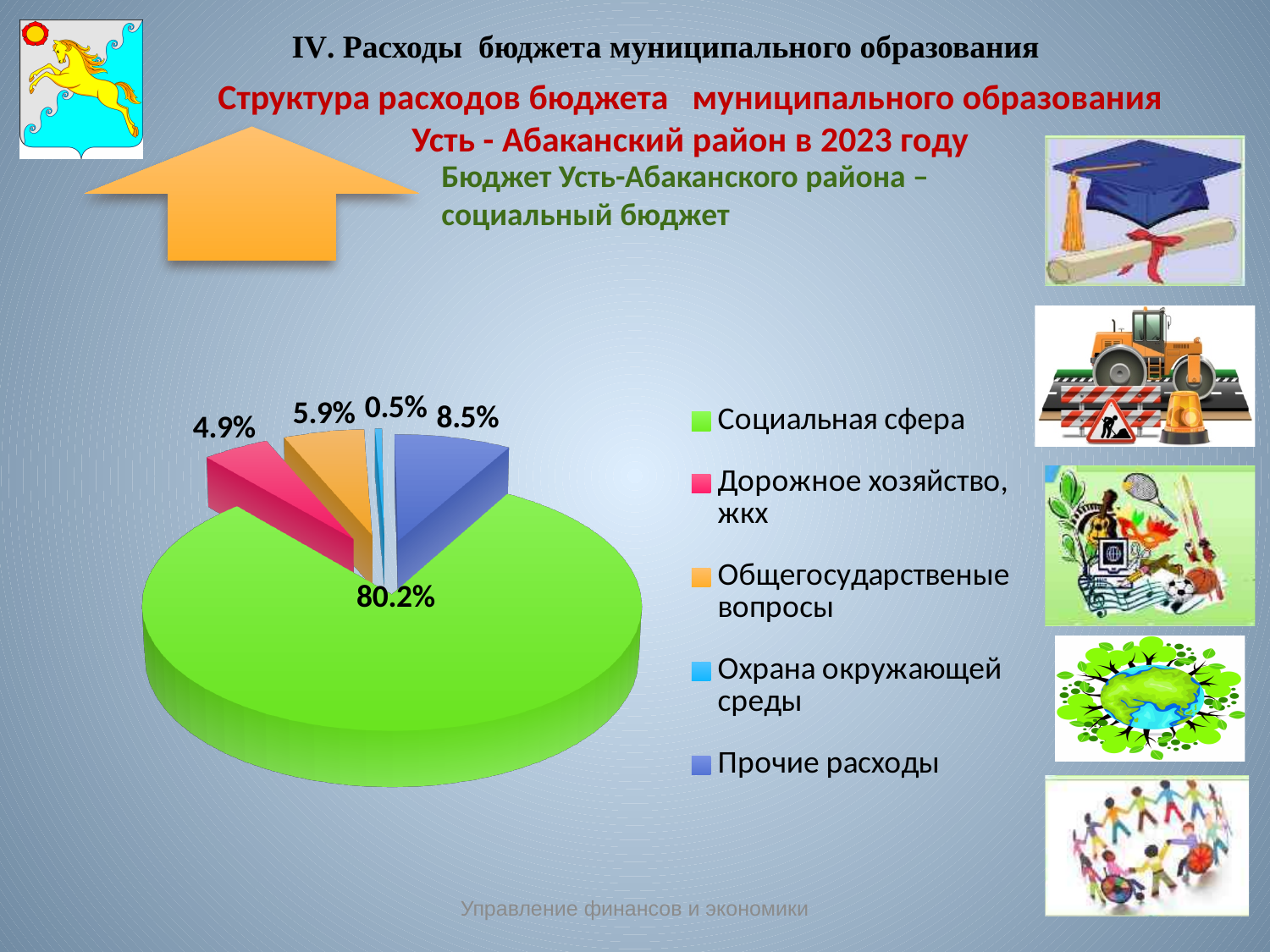
What kind of chart is shown on the slide? pie chart What colour is the slice for Социальная сфера? green What share of the pie does Социальная сфера have? 80.2% What is the value for Общегосударственые вопросы? 5.9% What is the value for Дорожное хозяйство, жкх? 4.9% What is the value for Прочие расходы? 8.5% Which is larger, Прочие расходы or Общегосударственые вопросы? Прочие расходы What is the value for Охрана окружающей среды? 0.5% Which category has the smallest share of the pie? Охрана окружающей среды Which category has the largest share of the pie? Социальная сфера How many categories does the legend list? 5 What is the difference between the shares of Прочие расходы and Дорожное хозяйство, жкх? 3.6%